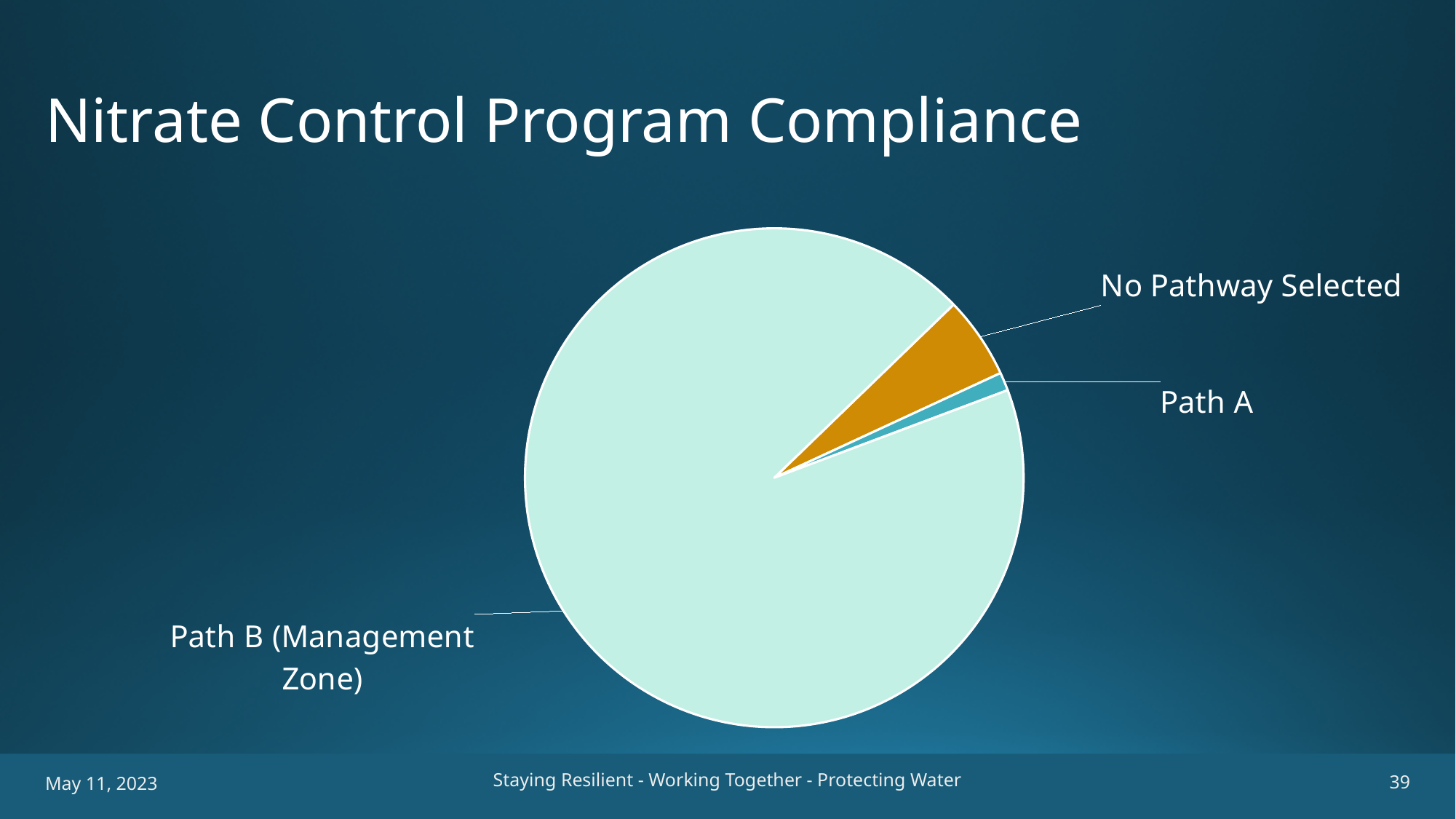
What is the title of the slide containing the pie chart? Nitrate Control Program Compliance What colour is the No Pathway Selected slice? Orange Which slice of the pie chart is the largest? Path B (Management Zone) Which slice is larger, No Pathway Selected or Path A? No Pathway Selected What kind of chart is shown on the slide? Pie chart Which slice is larger, Path B (Management Zone) or No Pathway Selected? Path B (Management Zone) How many slices does the pie chart have? 3 Does the Path B (Management Zone) slice make up more or less than half of the pie? More Which slice of the pie chart is the smallest? Path A